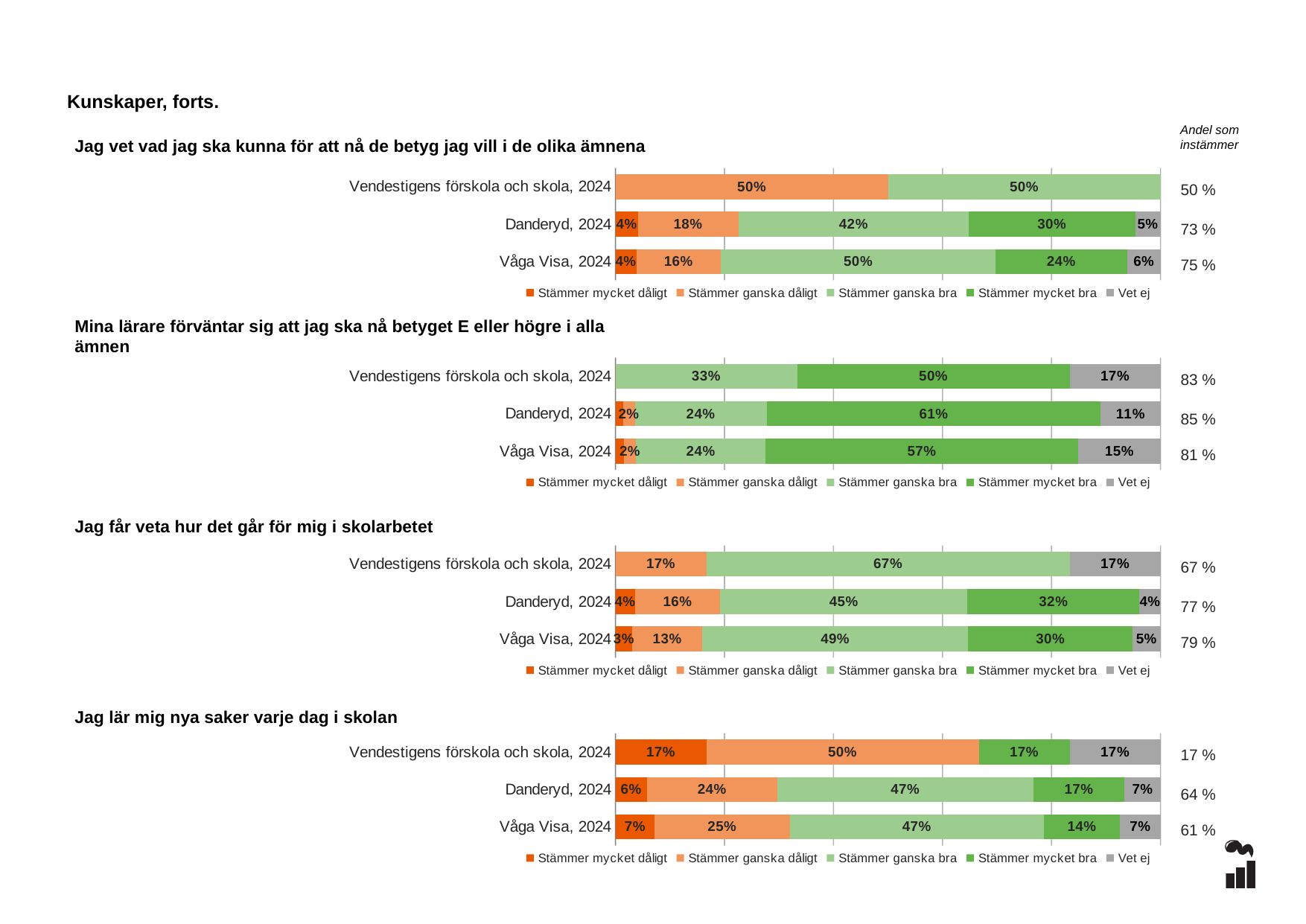
What kind of chart is "Mina lärare förväntar sig att jag ska nå betyget E eller högre i alla ämnen"? Stacked bar chart In the chart "Jag lär mig nya saker varje dag i skolan", what is the "Stämmer ganska dåligt" value for Vendestigens förskola och skola, 2024? 50% In the chart "Jag vet vad jag ska kunna för att nå de betyg jag vill i de olika ämnena", what is the "Stämmer mycket bra" value for Våga Visa, 2024? 24% In the chart "Jag vet vad jag ska kunna för att nå de betyg jag vill i de olika ämnena", what is the "Stämmer ganska bra" value for Danderyd, 2024? 42% In the chart "Jag får veta hur det går för mig i skolarbetet", what is the "Stämmer ganska bra" value for Vendestigens förskola och skola, 2024? 67% How many series does the legend list for the chart "Jag vet vad jag ska kunna för att nå de betyg jag vill i de olika ämnena"? 5 In the chart "Jag lär mig nya saker varje dag i skolan", is the "Stämmer ganska dåligt" value larger for Danderyd, 2024 or Våga Visa, 2024? Våga Visa, 2024 In the chart "Jag lär mig nya saker varje dag i skolan", which category has the lowest "Stämmer mycket dåligt" value? Danderyd, 2024 In the chart "Jag får veta hur det går för mig i skolarbetet", what is the difference between the "Stämmer mycket bra" values for Danderyd, 2024 and Våga Visa, 2024? 2% In the chart "Mina lärare förväntar sig att jag ska nå betyget E eller högre i alla ämnen", which category has the highest "Stämmer mycket bra" value? Danderyd, 2024 How many categories are shown in the chart "Jag får veta hur det går för mig i skolarbetet"? 3 In the chart "Mina lärare förväntar sig att jag ska nå betyget E eller högre i alla ämnen", what is the "Stämmer mycket bra" value for Danderyd, 2024? 61%